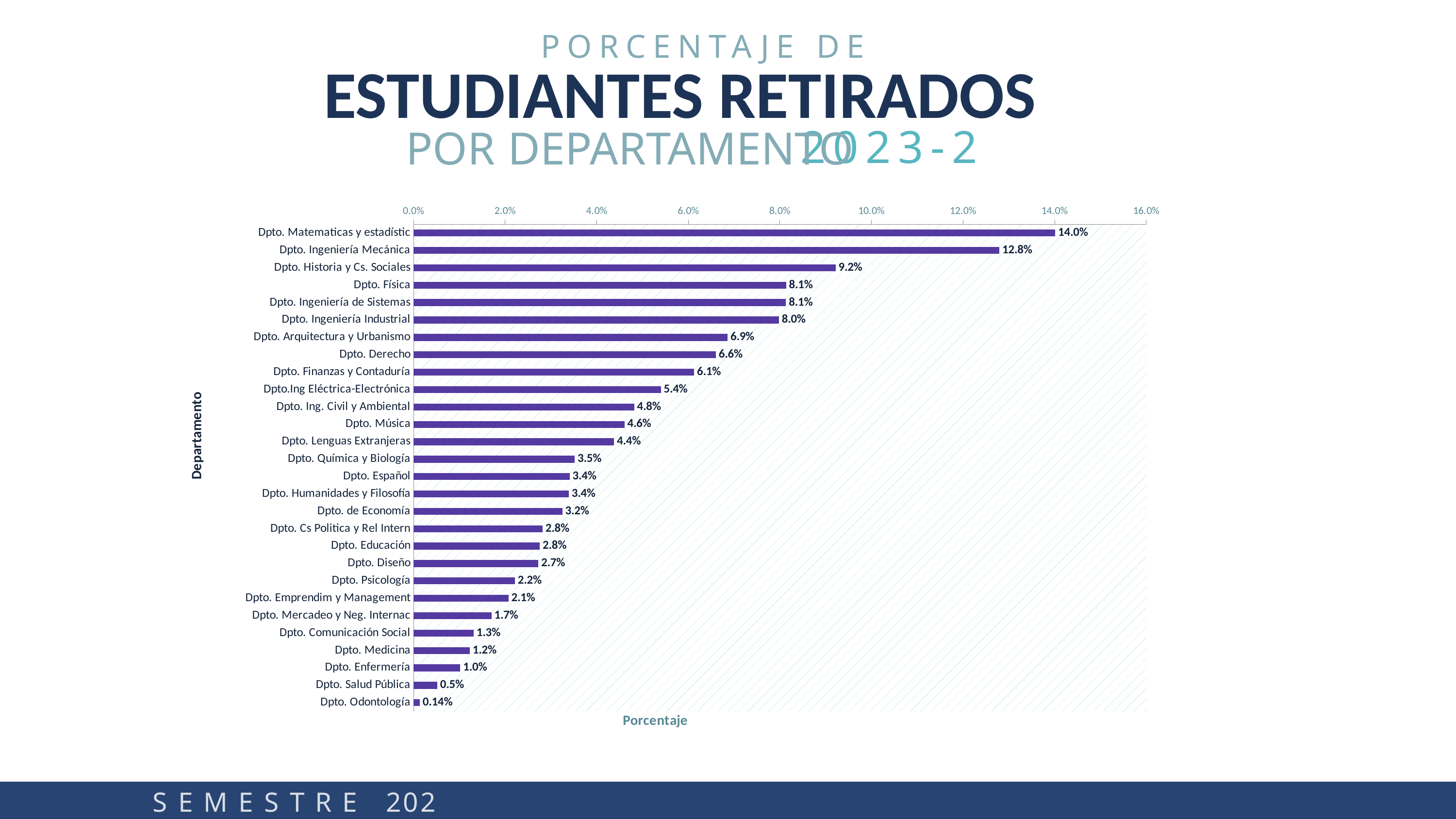
What is the label of the horizontal axis? Porcentaje What is the value for Dpto. Odontología? 0.14% How many departments are shown in the chart? 28 What is the value for Dpto. Química y Biología? 3.5% What kind of chart is shown on the slide? bar chart Which is larger, the value for Dpto. Historia y Cs. Sociales or the value for Dpto. Física? Dpto. Historia y Cs. Sociales Which department has the highest percentage? Dpto. Matematicas y estadístic Is the value for Dpto. Arquitectura y Urbanismo greater or less than 6.0%? greater Which department has the lowest percentage? Dpto. Odontología What is the value for Dpto. Derecho? 6.6% What is the difference between the values for Dpto. Matematicas y estadístic and Dpto. Ingeniería Mecánica? 1.2% What is the value for Dpto. Ingeniería Mecánica? 12.8%